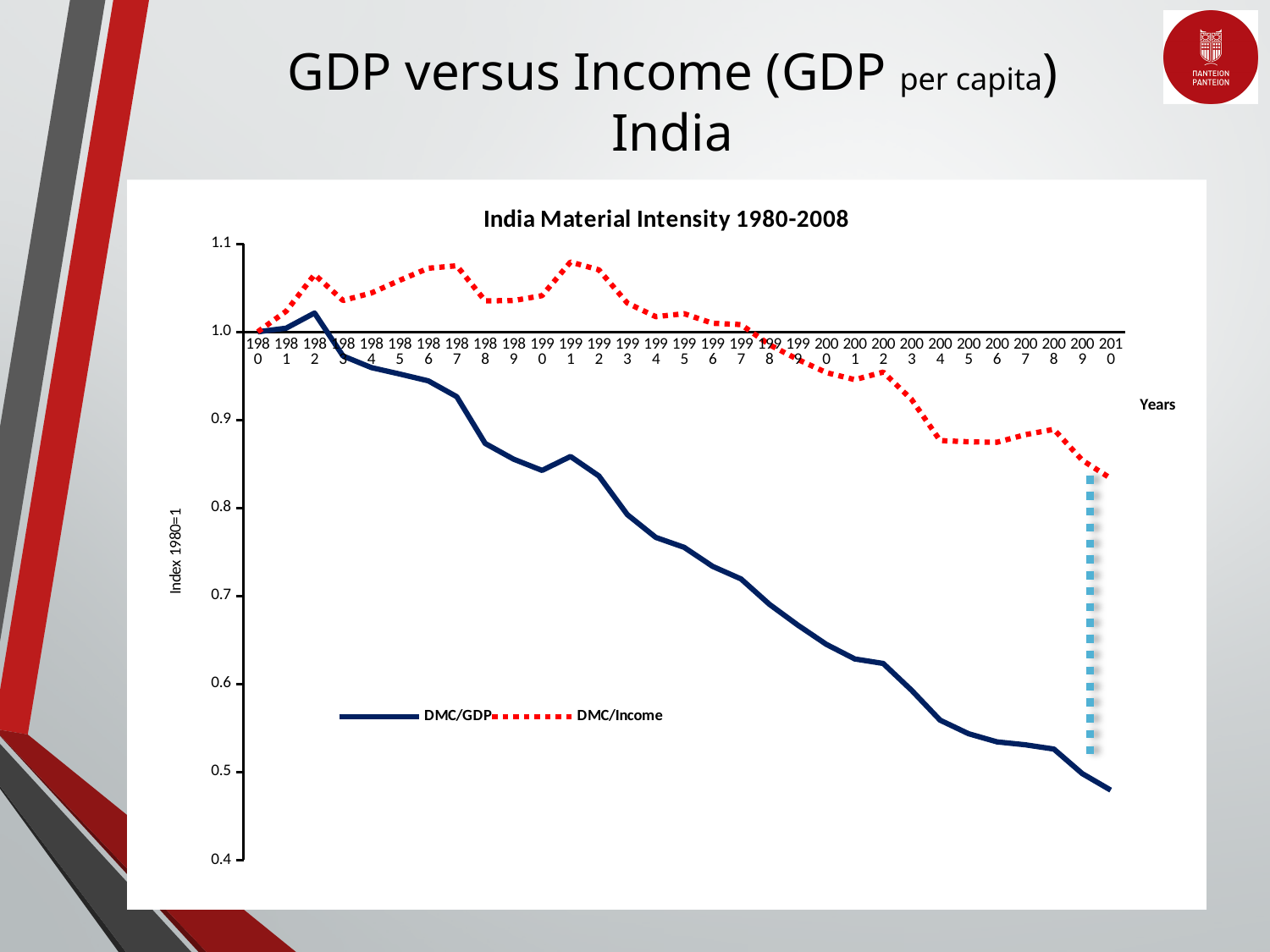
Which series is drawn with a dotted red line? DMC/Income How many series does the legend list? 2 What kind of chart is shown on the slide? line chart In 2010, which series has the higher value, DMC/GDP or DMC/Income? DMC/Income Is the DMC/GDP value for 2010 greater or less than 0.6? less Is the DMC/GDP value higher in 1990 or in 2000? 1990 In which year is the DMC/GDP series at its lowest? 2010 Is the DMC/Income value for 2010 greater or less than 0.9? less What is the label on the vertical axis? Index 1980=1 Is the DMC/Income value for 1991 greater or less than 1.0? greater What is the title of the chart? India Material Intensity 1980-2008 Does the DMC/GDP series rise or fall from 1980 to 2010? fall